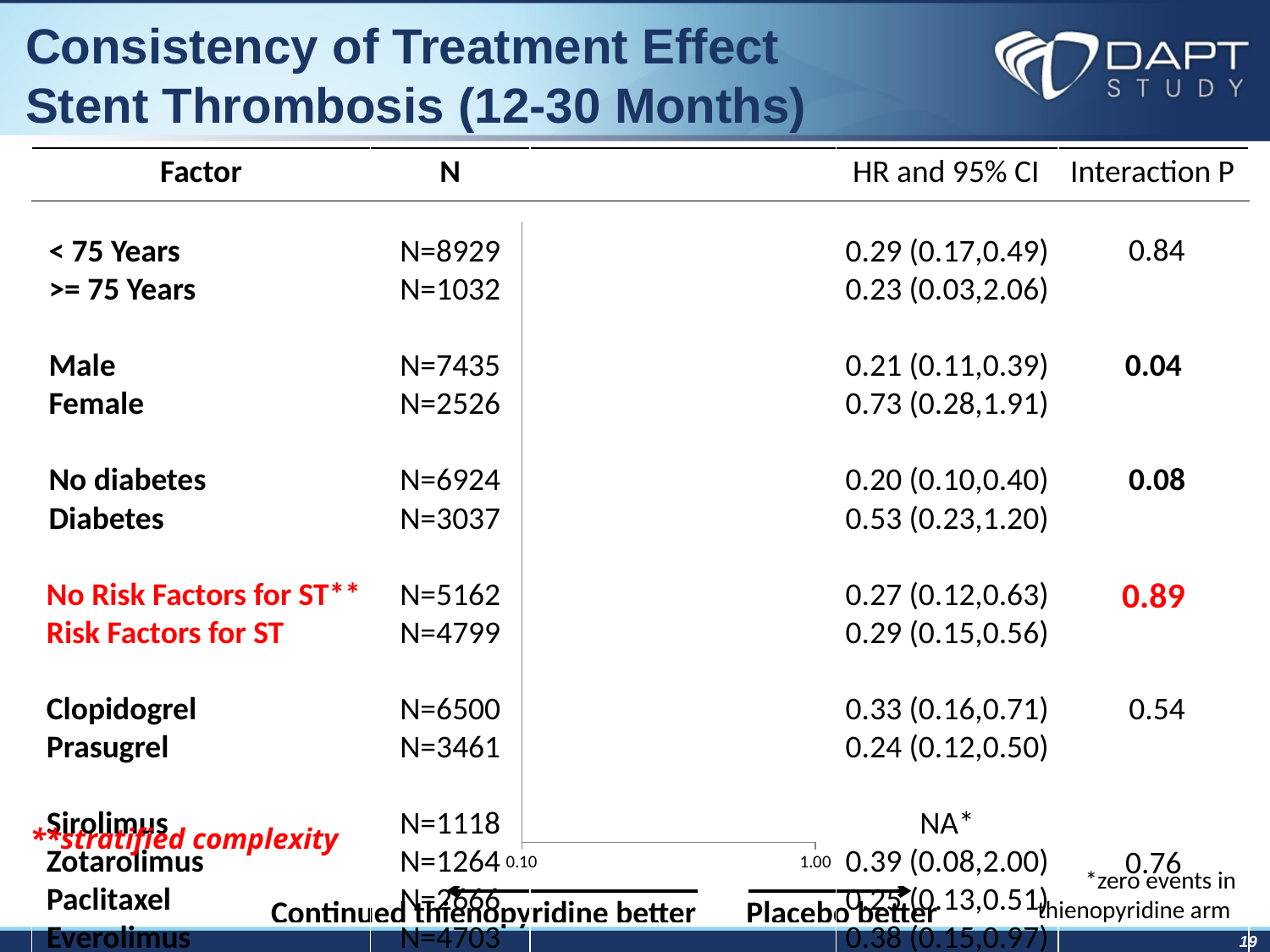
What is the N for the Female subgroup? N=2526 What is the interaction P value for the age comparison (< 75 Years vs >= 75 Years)? 0.84 What is shown as the HR for Sirolimus? NA* Is the HR for No diabetes greater or less than 1.00? less What is the HR and 95% CI for Male? 0.21 (0.11,0.39) What is the difference in N between Clopidogrel (N=6500) and Prasugrel (N=3461)? 3039 What does the left side of the horizontal axis indicate? Continued thienopyridine better Which has the larger point estimate HR, Male or Female? Female Which interaction P value is the smallest on the slide? 0.04 What is the HR and 95% CI for Risk Factors for ST? 0.29 (0.15,0.56) What is the HR and 95% CI for Zotarolimus? 0.39 (0.08,2.00) What is the interaction P value for the diabetes comparison (No diabetes vs Diabetes)? 0.08